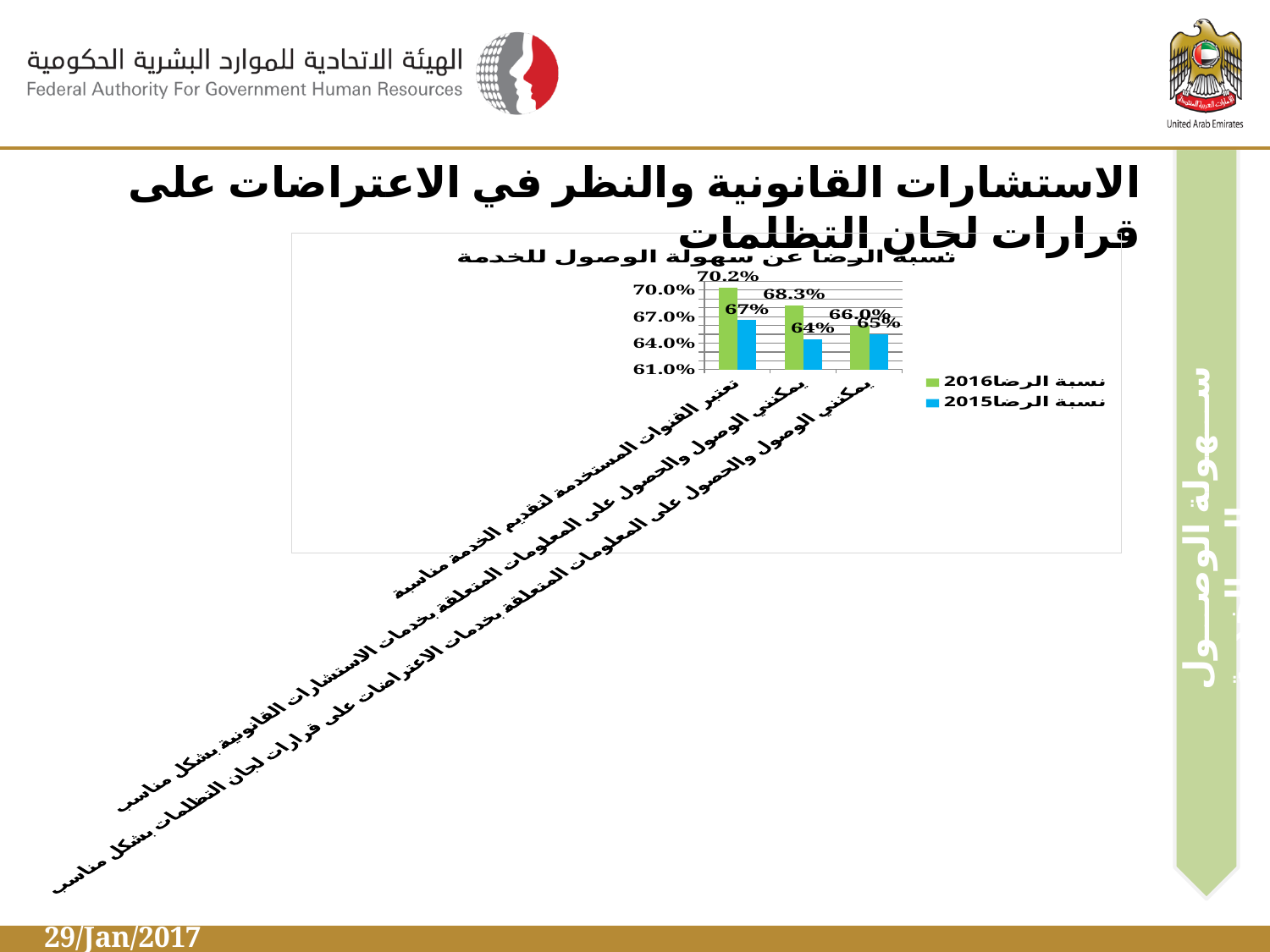
What is the difference between the 2016 and 2015 satisfaction values for the first (leftmost) category? 3.2 percentage points What is the نسبة الرضا2016 value for the first (leftmost) category, 'تعتبر القنوات المستخدمة لتقديم الخدمة مناسبة'? 70.2% What is the نسبة الرضا2016 value for the second (middle) category? 68.3% How many categories are plotted on the x axis of the chart? 3 What is the نسبة الرضا2015 value for the first (leftmost) category, 'تعتبر القنوات المستخدمة لتقديم الخدمة مناسبة'? 67% What is the نسبة الرضا2016 value for the third (rightmost) category? 66.0% Do the نسبة الرضا2016 values rise or fall from left to right across the categories? Fall For the third (rightmost) category, which is larger: the نسبة الرضا2016 value or the نسبة الرضا2015 value? نسبة الرضا2016 (66.0% vs 65%) Which category has the highest نسبة الرضا2016 value? تعتبر القنوات المستخدمة لتقديم الخدمة مناسبة (the first category) What is the نسبة الرضا2015 value for the second (middle) category? 64% How many series does the chart legend list? 2 What kind of chart is shown on the slide? Bar chart